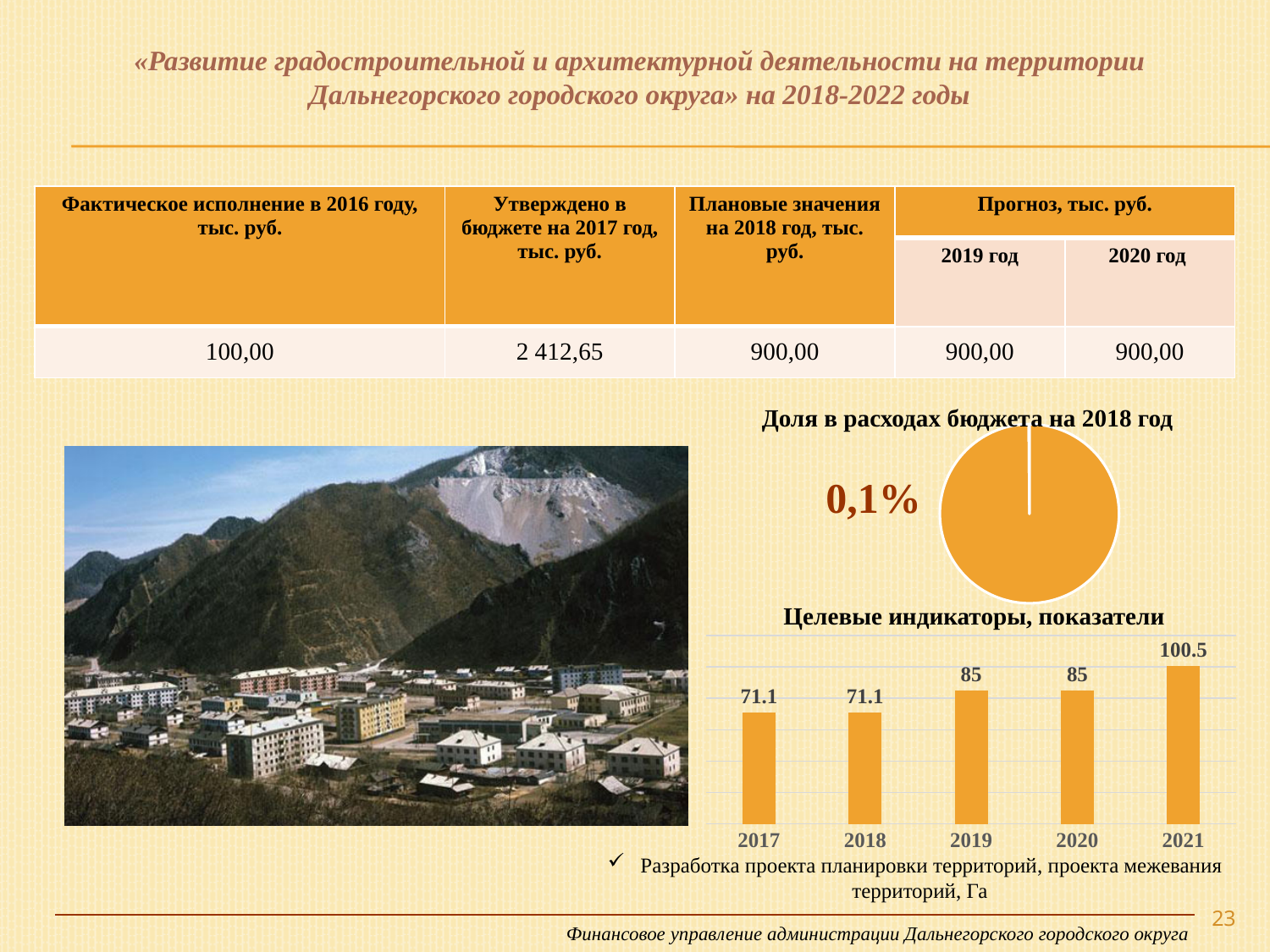
On the bar chart 'Целевые индикаторы, показатели', what is the value for 2021? 100.5 On the bar chart 'Целевые индикаторы, показатели', what is the value for 2017? 71.1 On the pie chart 'Доля в расходах бюджета на 2018 год', what share is printed next to the chart? 0,1% On the bar chart 'Целевые индикаторы, показатели', how many years are shown on the x axis? 5 On the bar chart 'Целевые индикаторы, показатели', what is the difference between the values for 2021 and 2020? 15.5 What kind of chart is 'Доля в расходах бюджета на 2018 год'? pie chart On the bar chart 'Целевые индикаторы, показатели', what is the value for 2019? 85 On the bar chart 'Целевые индикаторы, показатели', which year has the highest value? 2021 On the bar chart 'Целевые индикаторы, показатели', what is the difference between the values for 2019 and 2018? 13.9 What kind of chart is 'Целевые индикаторы, показатели'? bar chart On the bar chart 'Целевые индикаторы, показатели', do the values rise or fall from 2017 to 2021? rise On the bar chart 'Целевые индикаторы, показатели', which is larger, the value for 2018 or the value for 2020? 2020